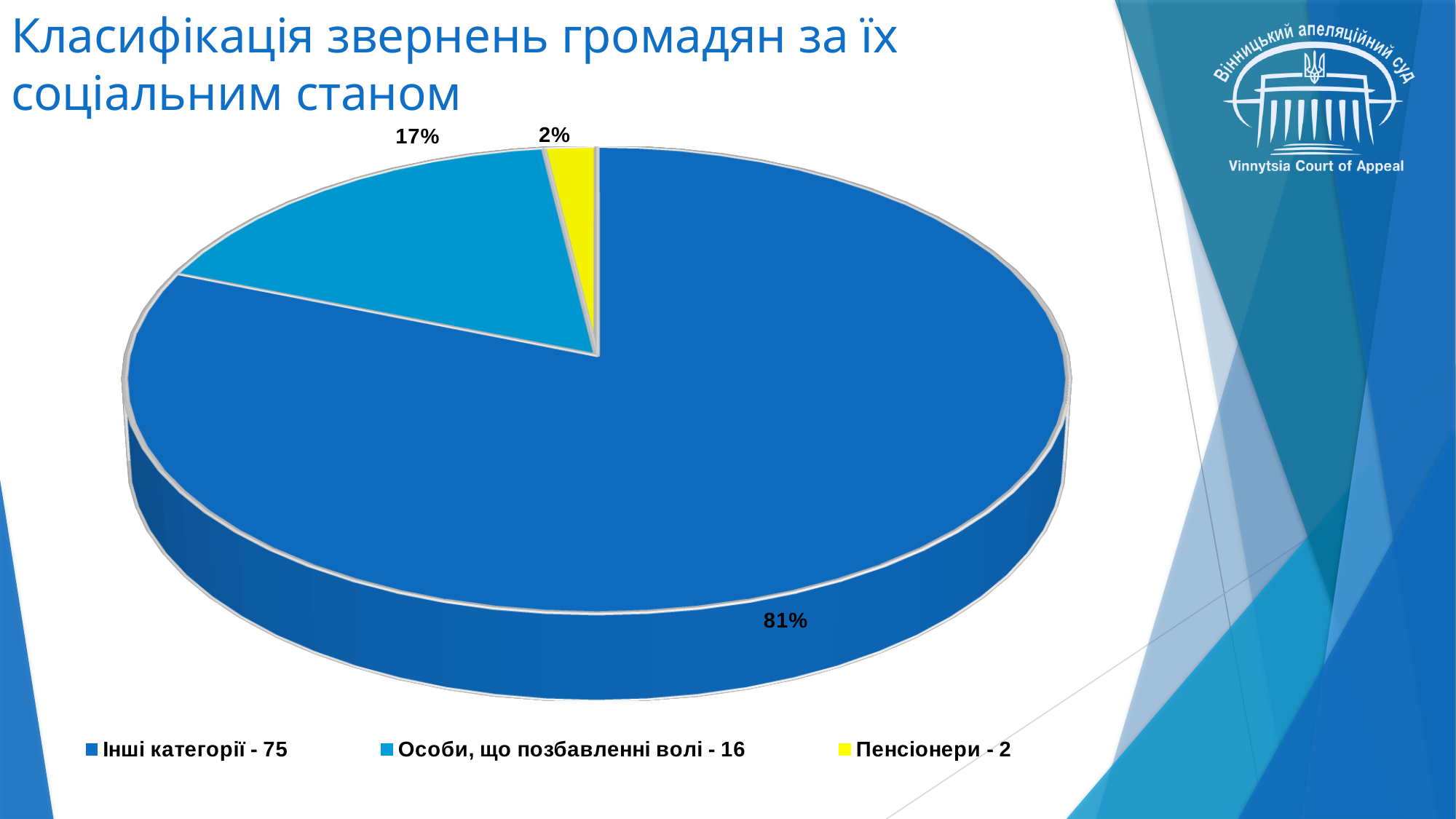
Which category has the smallest slice of the pie? Пенсіонери What percentage share does the slice for "Інші категорії" have? 81% What is the difference in percentage points between the "Інші категорії" slice and the "Особи, що позбавленні волі" slice? 64 How many categories does the pie chart show? 3 According to the legend, how many appeals are in the category "Пенсіонери"? 2 What type of chart is shown on the slide? Pie chart What percentage share does the slice for "Пенсіонери" have? 2% Which category has the largest slice of the pie? Інші категорії According to the legend, how many appeals are in the category "Інші категорії"? 75 According to the legend, how many appeals are in the category "Особи, що позбавленні волі"? 16 What percentage share does the slice for "Особи, що позбавленні волі" have? 17% Which is larger: the share for "Особи, що позбавленні волі" or the share for "Пенсіонери"? Особи, що позбавленні волі